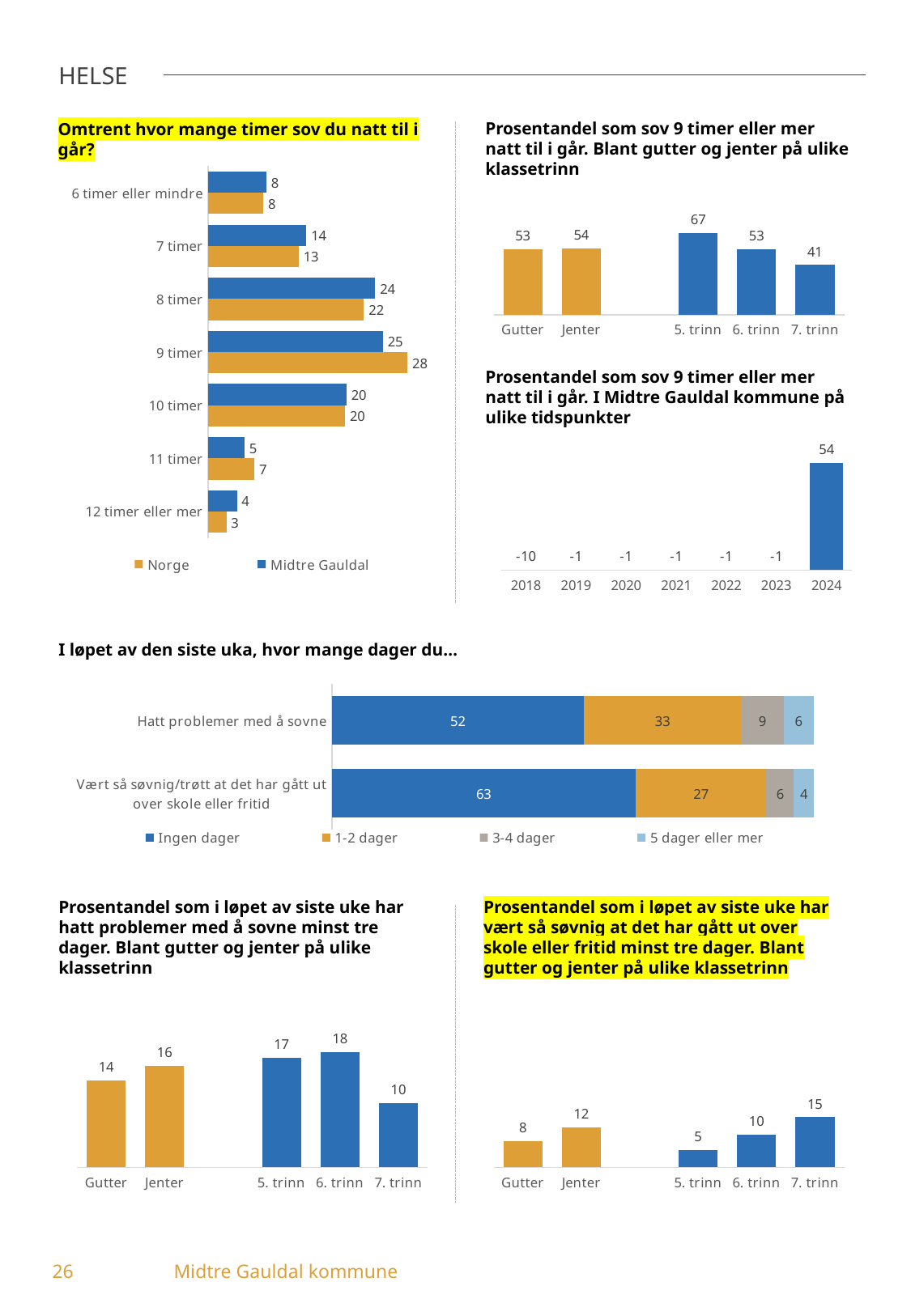
In the chart 'Omtrent hvor mange timer sov du natt til i går?', how many series does the legend list? 2 In the chart 'Prosentandel som sov 9 timer eller mer natt til i går. Blant gutter og jenter på ulike klassetrinn', which category has the highest value? 5. trinn In the chart 'Prosentandel som i løpet av siste uke har vært så søvnig at det har gått ut over skole eller fritid minst tre dager', which is larger, Gutter or Jenter? Jenter In the chart 'Omtrent hvor mange timer sov du natt til i går?', what is the value for Midtre Gauldal for '8 timer'? 24 In the stacked bar chart 'I løpet av den siste uka, hvor mange dager du…', what is the value of '1-2 dager' for 'Hatt problemer med å sovne'? 33 In the stacked bar chart 'I løpet av den siste uka, hvor mange dager du…', what is the total of the bar 'Vært så søvnig/trøtt at det har gått ut over skole eller fritid'? 100 In the stacked bar chart 'I løpet av den siste uka, hvor mange dager du…', what kind of chart is it? Stacked bar chart In the chart 'Prosentandel som sov 9 timer eller mer natt til i går. Blant gutter og jenter på ulike klassetrinn', what is the difference between 5. trinn and 7. trinn? 26 In the chart 'Omtrent hvor mange timer sov du natt til i går?', what is the value for Norge for '9 timer'? 28 In the chart 'Prosentandel som sov 9 timer eller mer natt til i går. I Midtre Gauldal kommune på ulike tidspunkter', what is the value for 2024? 54 In the chart 'Omtrent hvor mange timer sov du natt til i går?', how many categories are shown on the vertical axis? 7 In the chart 'Prosentandel som i løpet av siste uke har hatt problemer med å sovne minst tre dager', which category has the lowest value? 7. trinn